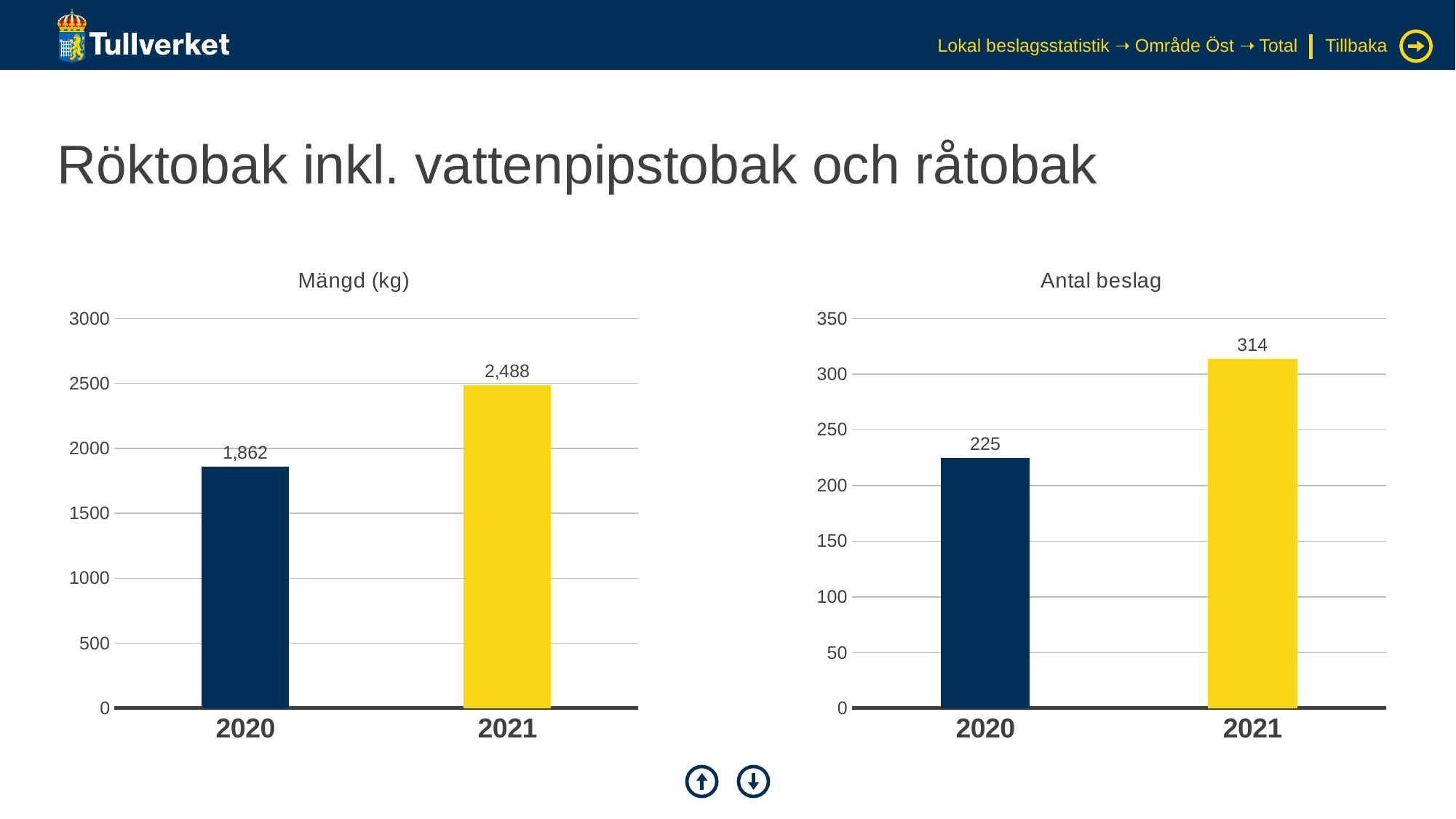
In the 'Antal beslag' chart, which year has the lowest value? 2020 How many bars are in the 'Mängd (kg)' chart? 2 In the 'Antal beslag' chart, what is the value for 2020? 225 In the 'Mängd (kg)' chart, which year has the highest value? 2021 In the 'Mängd (kg)' chart, what is the value for 2020? 1,862 In the 'Mängd (kg)' chart, what is the value for 2021? 2,488 In the 'Mängd (kg)' chart, what is the difference between the 2021 and 2020 values? 626 In the 'Antal beslag' chart, what is the value for 2021? 314 What kind of chart is the 'Antal beslag' chart? bar chart In the 'Mängd (kg)' chart, do the values rise or fall from 2020 to 2021? rise In the 'Antal beslag' chart, is the value for 2020 greater or less than 250? less In the 'Antal beslag' chart, what is the difference between the 2021 and 2020 values? 89